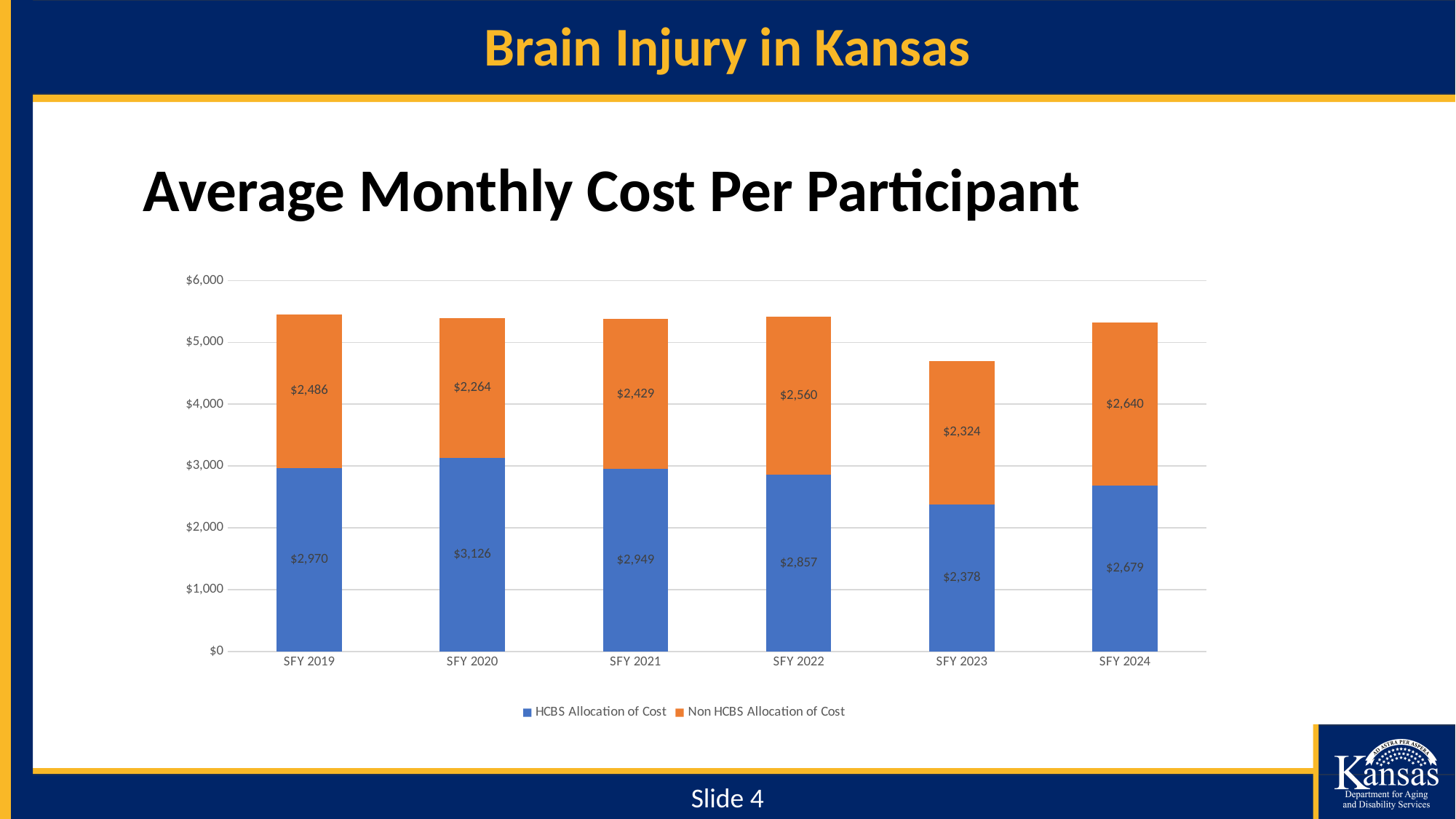
How many fiscal years are shown on the x axis? 6 Which fiscal year has the lowest HCBS Allocation of Cost? SFY 2023 What is the difference between the HCBS Allocation of Cost and the Non HCBS Allocation of Cost for SFY 2019? $484 Which fiscal year has the lowest Non HCBS Allocation of Cost? SFY 2020 How many series does the legend list? 2 What is the Non HCBS Allocation of Cost for SFY 2022? $2,560 Which is larger for SFY 2024, the HCBS Allocation of Cost or the Non HCBS Allocation of Cost? HCBS Allocation of Cost Which fiscal year has the highest HCBS Allocation of Cost? SFY 2020 What kind of chart is shown on the slide? Stacked bar chart What is the HCBS Allocation of Cost for SFY 2020? $3,126 What is the HCBS Allocation of Cost for SFY 2023? $2,378 What is the total average monthly cost per participant for SFY 2023? $4,702